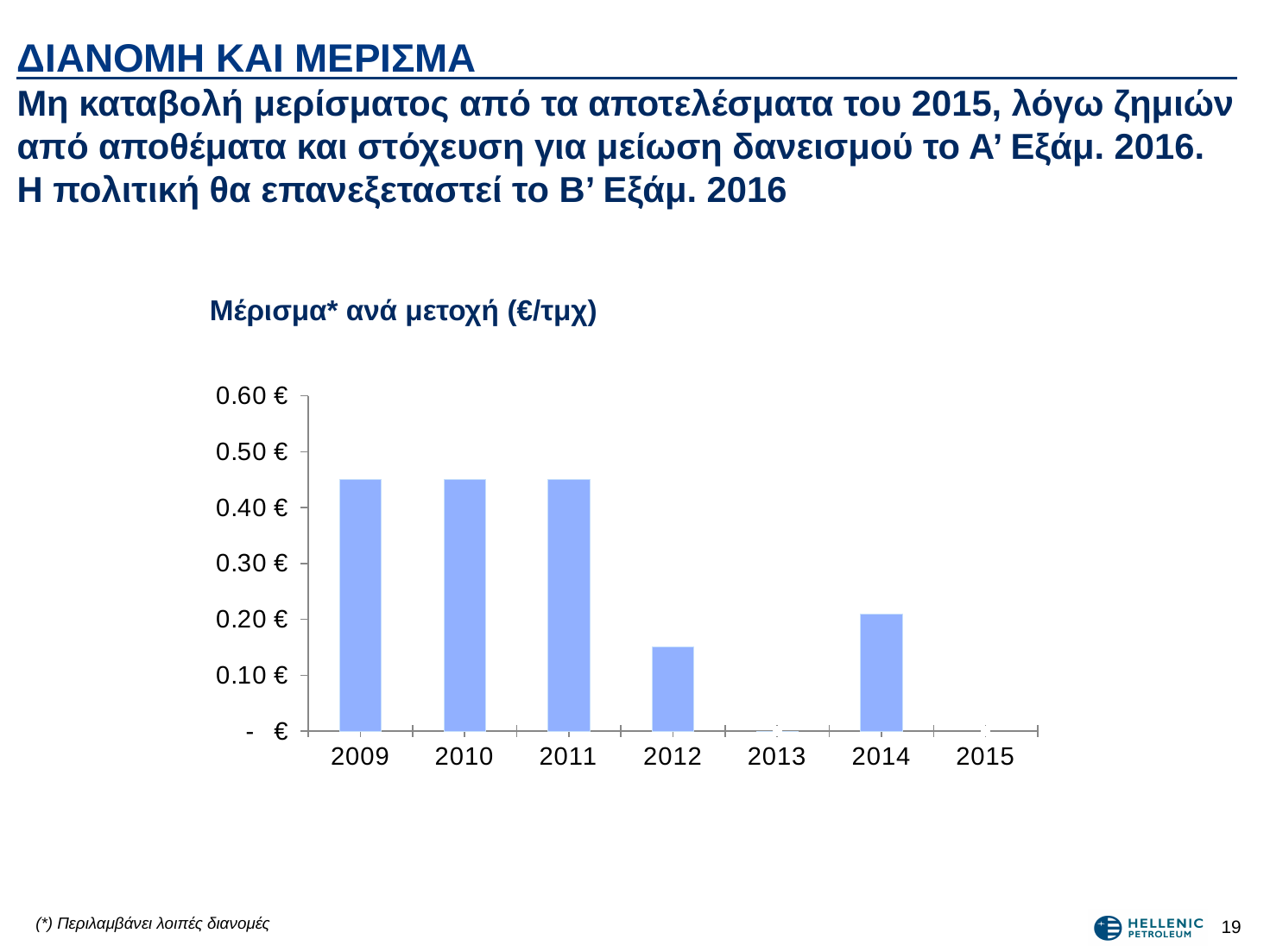
Which is larger, the value for 2012 or the value for 2014? 2014 Is the value for 2011 greater or less than 0.50 €? less Do the values generally rise or fall from 2009 to 2015? fall What is the title of the chart? Μέρισμα* ανά μετοχή (€/τμχ) How many years are shown on the x axis of the chart? 7 Is the value for 2012 greater or less than 0.10 €? greater What kind of chart is shown on the slide? bar chart Is the value for 2009 greater or less than 0.40 €? greater Which is larger, the value for 2010 or the value for 2012? 2010 Which years show no bar (a dividend of zero) in the chart? 2013 and 2015